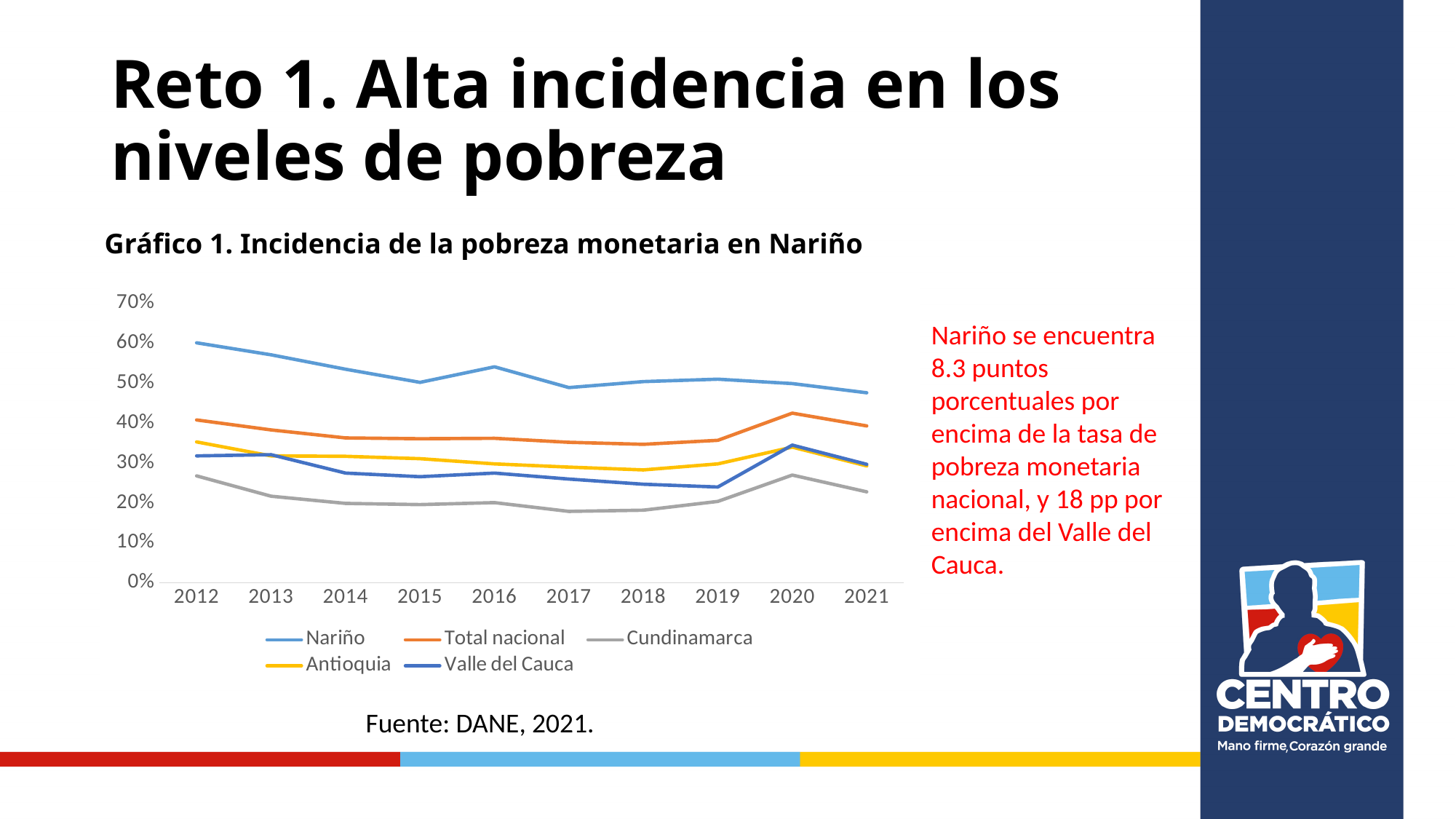
Is the value for Total nacional in 2020 greater or less than 40%? greater Which series has the highest value in 2012 in Gráfico 1? Nariño Is the value for Nariño in 2012 greater or less than 50%? greater In 2021, which is larger: Nariño or Total nacional? Nariño How many series does the legend of Gráfico 1 list? 5 What kind of chart is Gráfico 1? Line chart Does the Nariño line rise or fall from 2012 to 2015? Fall Which series has the lowest value in 2017 in Gráfico 1? Cundinamarca What is the title of the chart on the slide? Gráfico 1. Incidencia de la pobreza monetaria en Nariño Is the value for Cundinamarca in 2017 greater or less than 20%? less How many years are shown on the x axis of Gráfico 1? 10